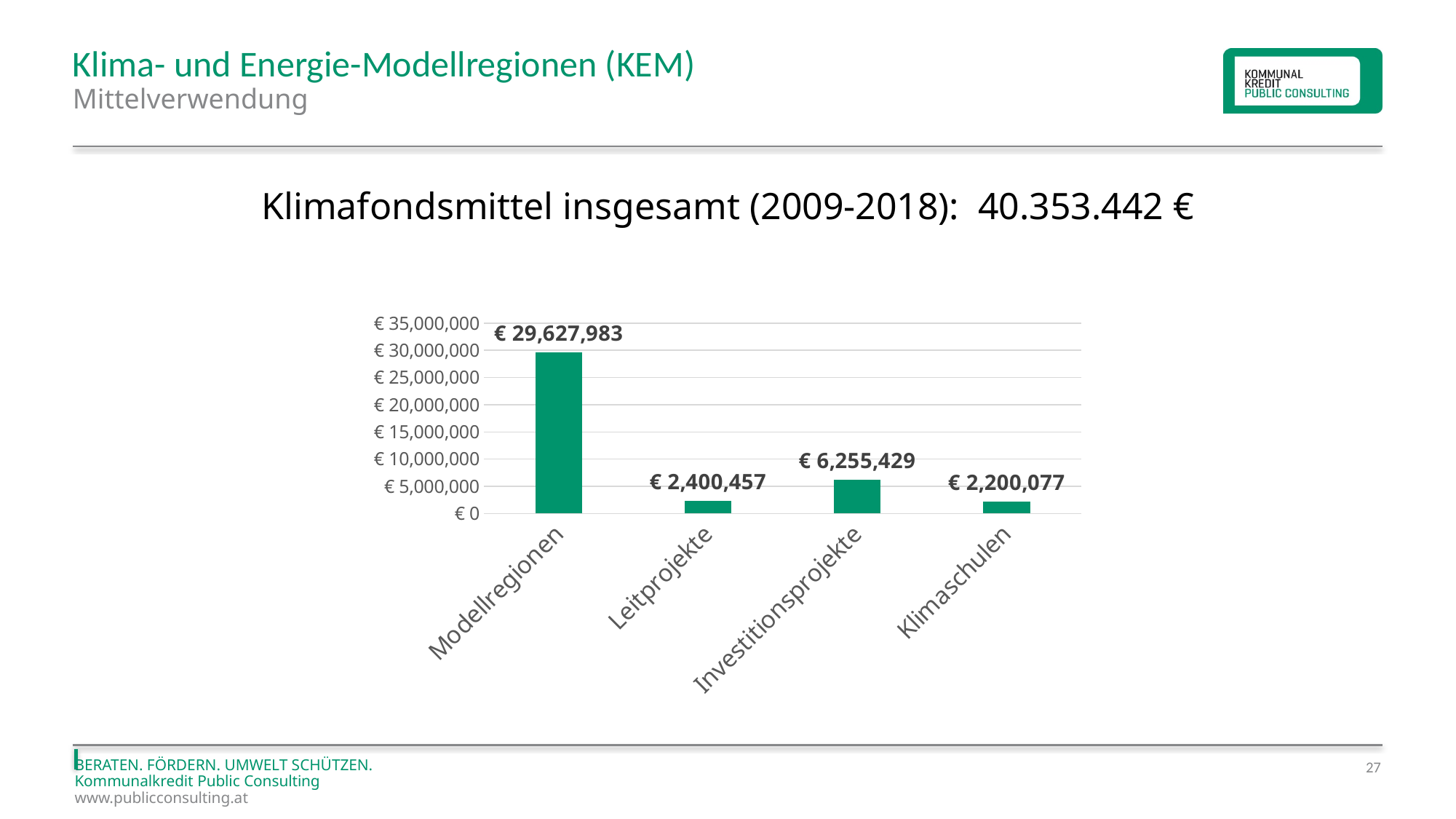
What is the difference between the values for Modellregionen and Investitionsprojekte? € 23,372,554 What is the value for Investitionsprojekte? € 6,255,429 Which category has the highest value? Modellregionen What is the value for Leitprojekte? € 2,400,457 What is the difference between the values for Investitionsprojekte and Leitprojekte? € 3,854,972 What kind of chart is shown on the slide? bar chart Which category has the lowest value? Klimaschulen What is the value for Klimaschulen? € 2,200,077 What is the value for Modellregionen? € 29,627,983 Is the value for Modellregionen greater or less than € 25,000,000? greater How many categories are shown in the chart? 4 Which is larger, the value for Investitionsprojekte or the value for Leitprojekte? Investitionsprojekte